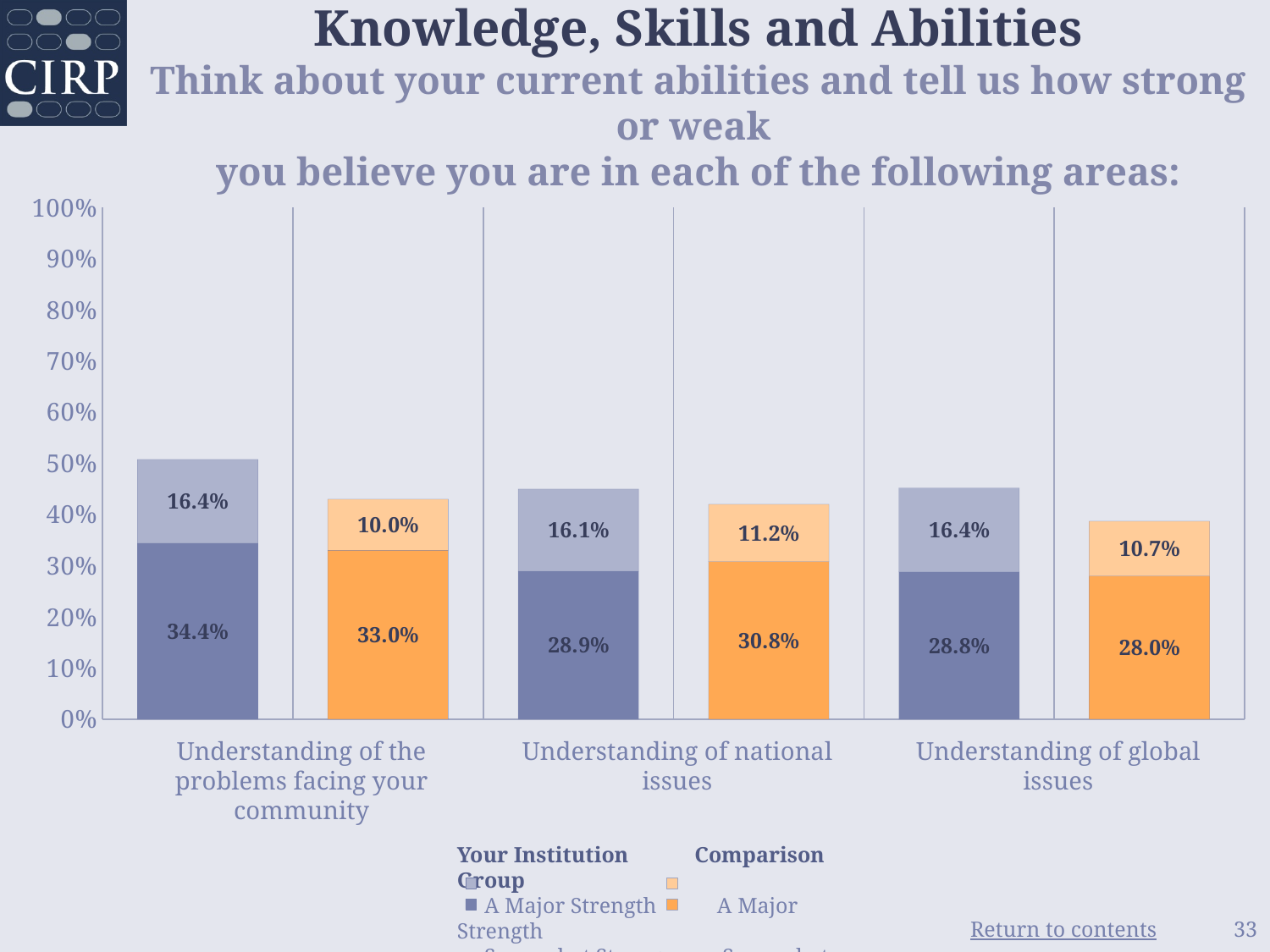
What is the total height of the Your Institution stacked bar for 'Understanding of the problems facing your community'? 50.8% What is the value of the lighter top segment of the Your Institution bar for 'Understanding of national issues'? 16.1% What kind of chart is shown on the slide? stacked bar chart Which area has the lowest A Major Strength percentage for the Comparison Group? Understanding of global issues What percentage of the Comparison Group rated 'Understanding of national issues' as A Major Strength? 30.8% What percentage of Your Institution students rated 'Understanding of the problems facing your community' as A Major Strength? 34.4% Which area has the highest A Major Strength percentage for Your Institution? Understanding of the problems facing your community For 'Understanding of national issues', which group has the larger A Major Strength percentage, Your Institution or the Comparison Group? Comparison Group What is the value of the lighter top segment of the Comparison Group bar for 'Understanding of global issues'? 10.7% How many areas (categories) are shown along the x axis? 3 What is the total height of the Comparison Group stacked bar for 'Understanding of global issues'? 38.7% What is the difference between the Your Institution and Comparison Group A Major Strength percentages for 'Understanding of global issues'? 0.8%